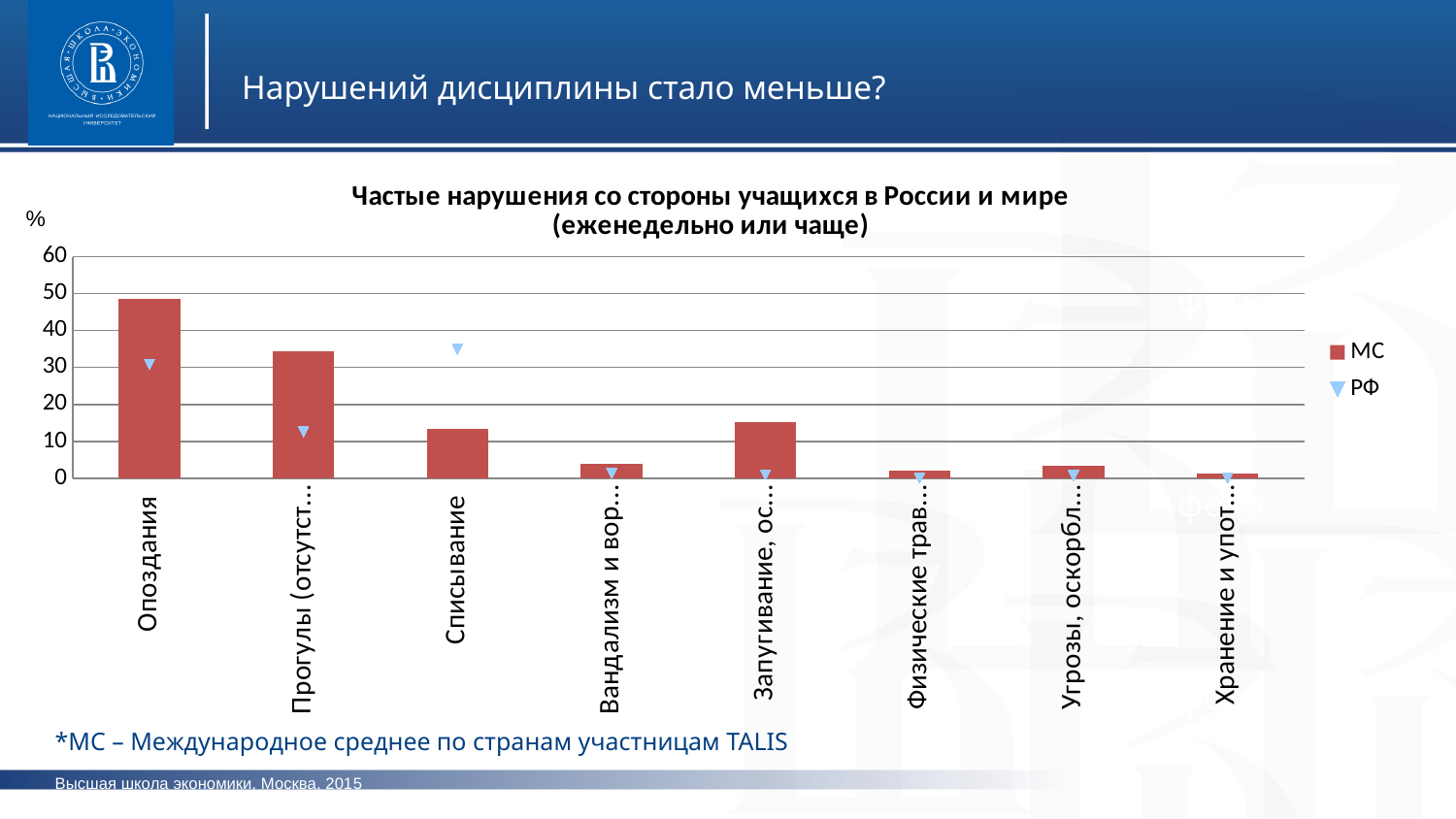
Which category has the highest РФ value? Списывание Is the MC value for Опоздания greater or less than 40? greater Is the РФ value for Списывание greater or less than 30? greater Is the MC value for Списывание greater or less than 20? less How many categories are shown on the x axis? 8 How many series does the legend list? 2 Which category has the highest MC value? Опоздания For Списывание, which series has the larger value, MC or РФ? РФ What kind of chart is shown on the slide? bar chart For Опоздания, which series has the larger value, MC or РФ? MC What are the two legend entries of the chart? MC and РФ